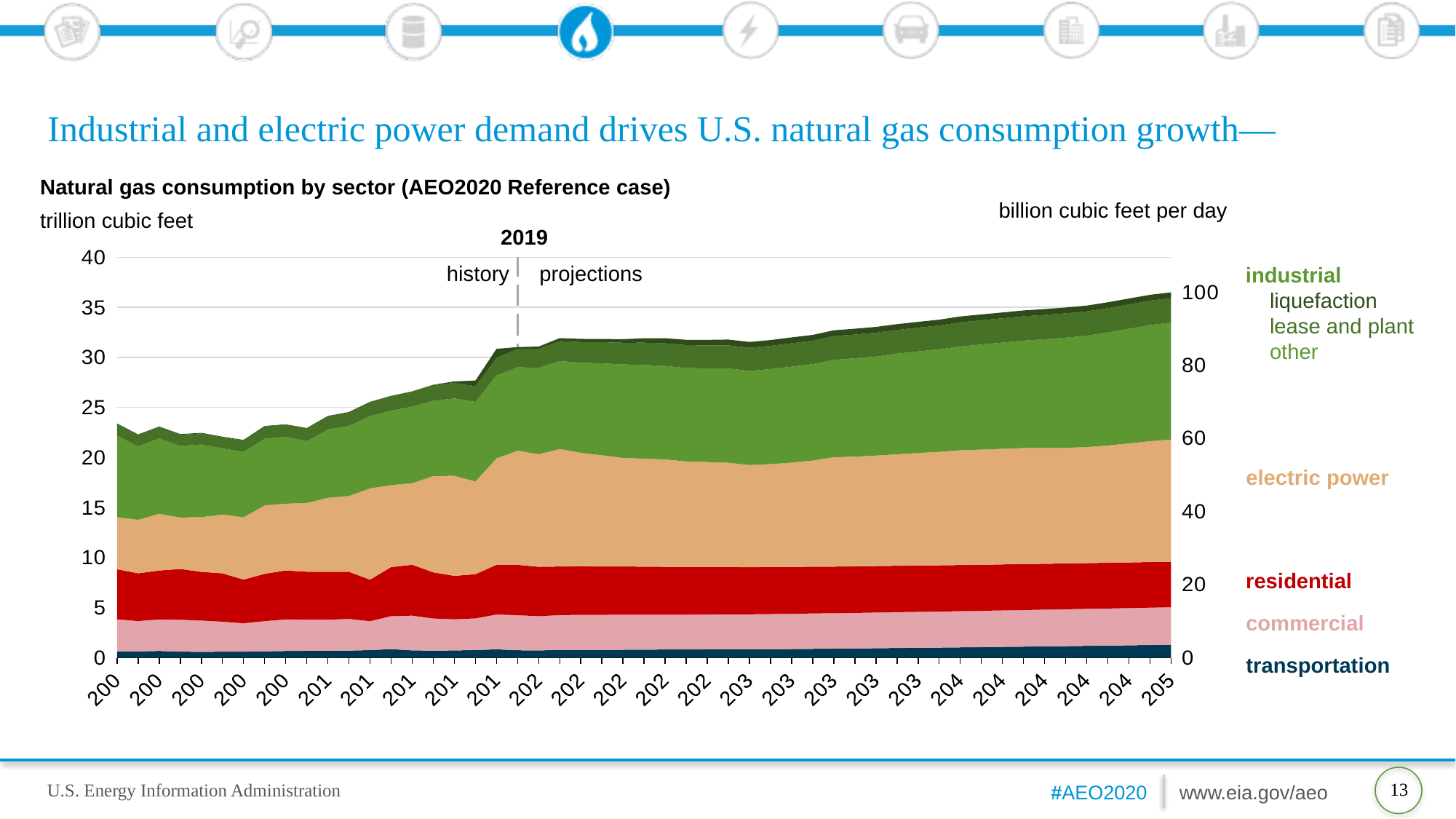
Which sector is listed at the bottom of the legend? transportation At the right end of the chart, which band is larger: electric power or residential? electric power What unit is shown on the left axis of the chart? trillion cubic feet Does total natural gas consumption rise or fall over the projection period? rise Which sector has the smallest band in the chart? transportation Is the total natural gas consumption at the right end of the chart (2050) greater or less than 35 trillion cubic feet? greater What kind of chart is shown on the slide? stacked area chart What is the title of the chart? Natural gas consumption by sector (AEO2020 Reference case) Is the total natural gas consumption at the left end of the chart (2000) greater or less than 25 trillion cubic feet? less What year separates history from projections in the chart? 2019 What is the highest tick value on the right axis (billion cubic feet per day)? 100 What is the highest tick value on the left axis? 40